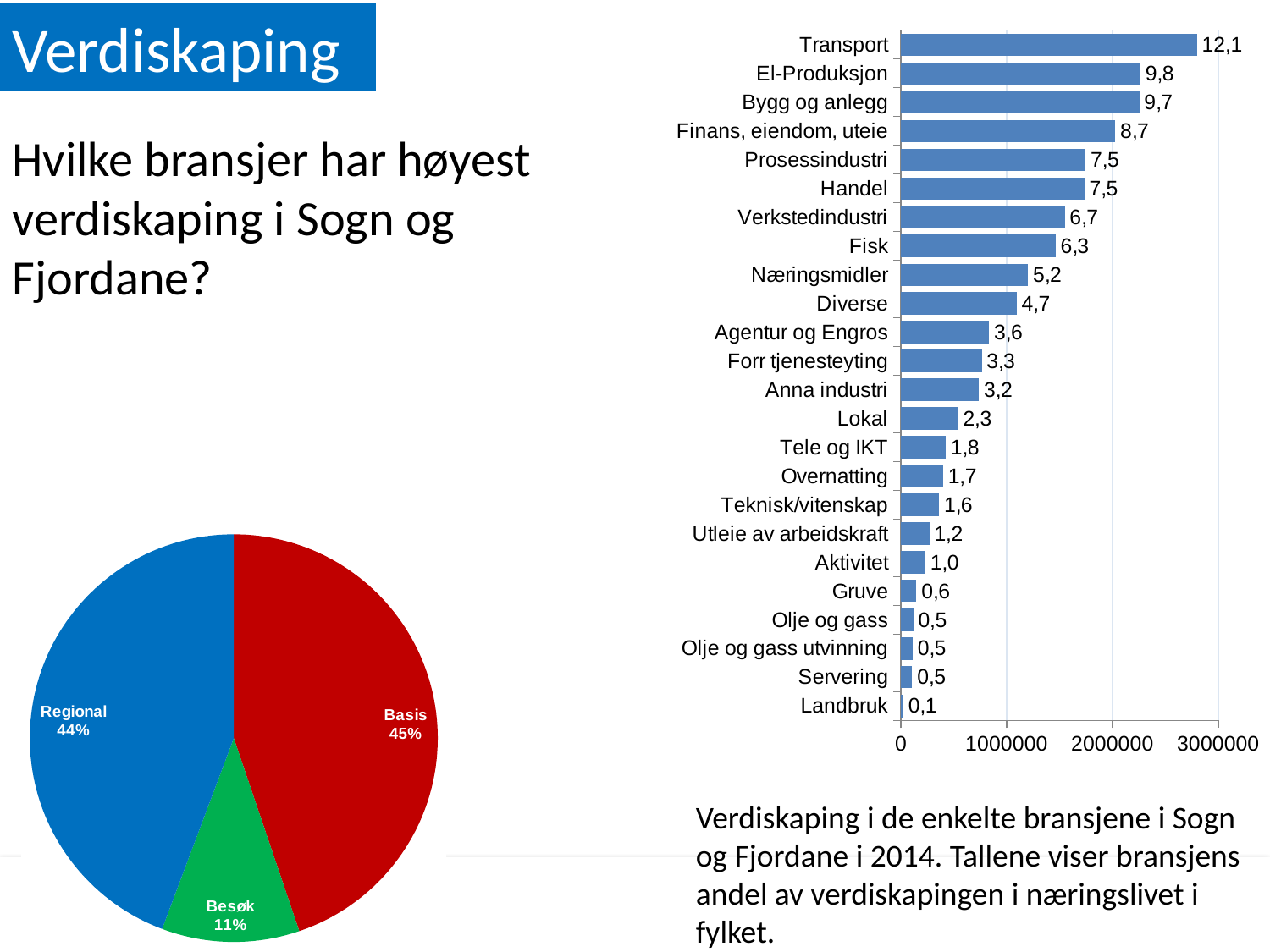
What kind of chart is the chart on the right of the slide? Bar chart In the bar chart on the right, which category has the highest value? Transport In the bar chart on the right, which category has the lowest value? Landbruk In the bar chart on the right, what is the value shown for Transport? 12,1 In the bar chart on the right, what is the value shown for Fisk? 6,3 In the bar chart on the right, is the bar for Transport greater or less than 2000000 on the axis? greater In the bar chart on the right, is the bar for Fisk greater or less than 2000000 on the axis? less In the pie chart on the left, what share does Besøk have? 11% How many slices does the pie chart on the left have? 3 How many categories are shown in the bar chart on the right? 24 In the bar chart on the right, which is larger, the value for Verkstedindustri or the value for Næringsmidler? Verkstedindustri In the bar chart on the right, what is the difference between the values for Transport and El-Produksjon? 2,3